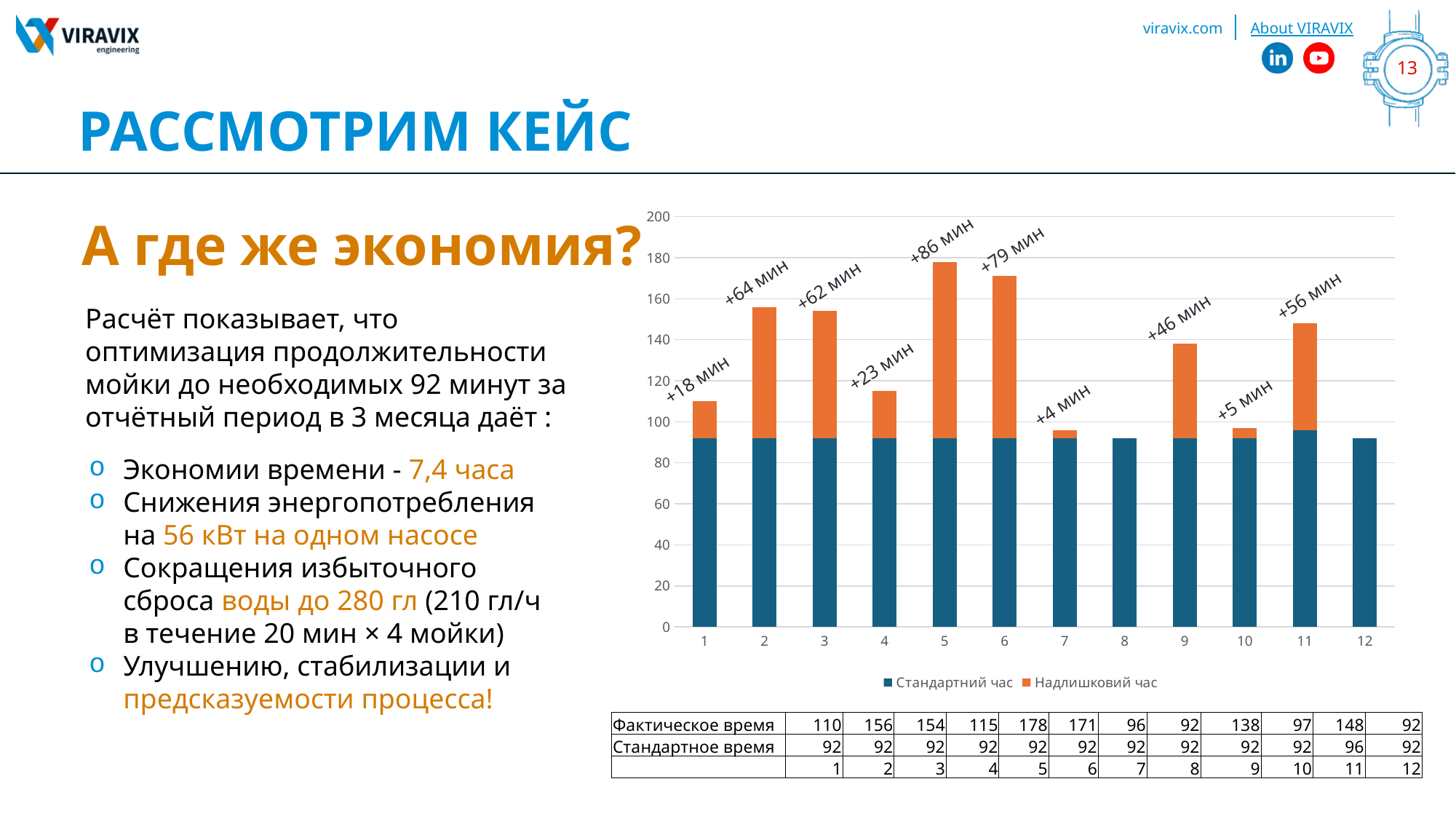
What kind of chart is shown on the slide? bar chart Is the total bar height for category 9 greater or less than 120? greater What is the total (Фактическое время) for category 2 according to the table under the chart? 156 How many categories are plotted along the x axis of the chart? 12 Which category has the largest excess time (Надлишковий час) segment? 5 Which has the larger excess time label, category 2 or category 3? 2 What excess time label is shown above the bar for category 1? +18 мин What are the two series named in the chart legend? Стандартний час and Надлишковий час What is the difference between the excess time labels for category 5 and category 6? 7 мин What excess time label is shown above the bar for category 5? +86 мин What is the standard time (Стандартное время) for category 11 in the table under the chart? 96 How many series does the chart legend list? 2